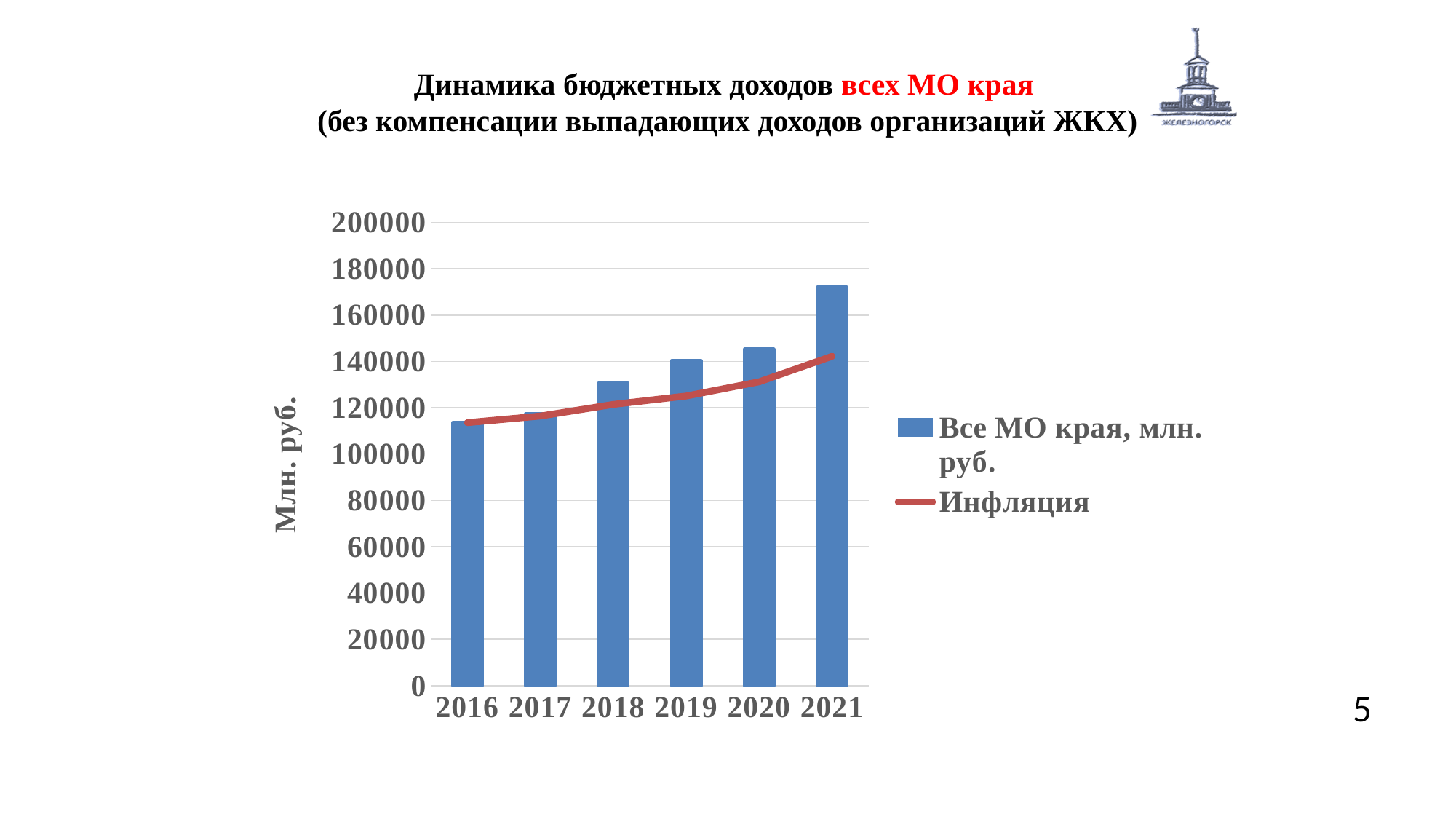
What kind of chart is shown on the slide? Bar chart with a line Which year has the highest bar for "Все МО края, млн. руб."? 2021 Is the bar value for 2021 greater or less than 160000? greater Is the bar value for 2018 greater or less than 120000? greater What is the label on the vertical axis of the chart? Млн. руб. Is the bar value for 2016 greater or less than 120000? less How many series does the chart legend list? 2 Which is larger, the bar value for 2019 or the bar value for 2021? 2021 What is the name of the series drawn as a red line in the chart? Инфляция How many years are shown on the x axis of the chart? 6 Do the bar values for "Все МО края, млн. руб." rise or fall from 2016 to 2021? Rise Which year has the lowest bar for "Все МО края, млн. руб."? 2016